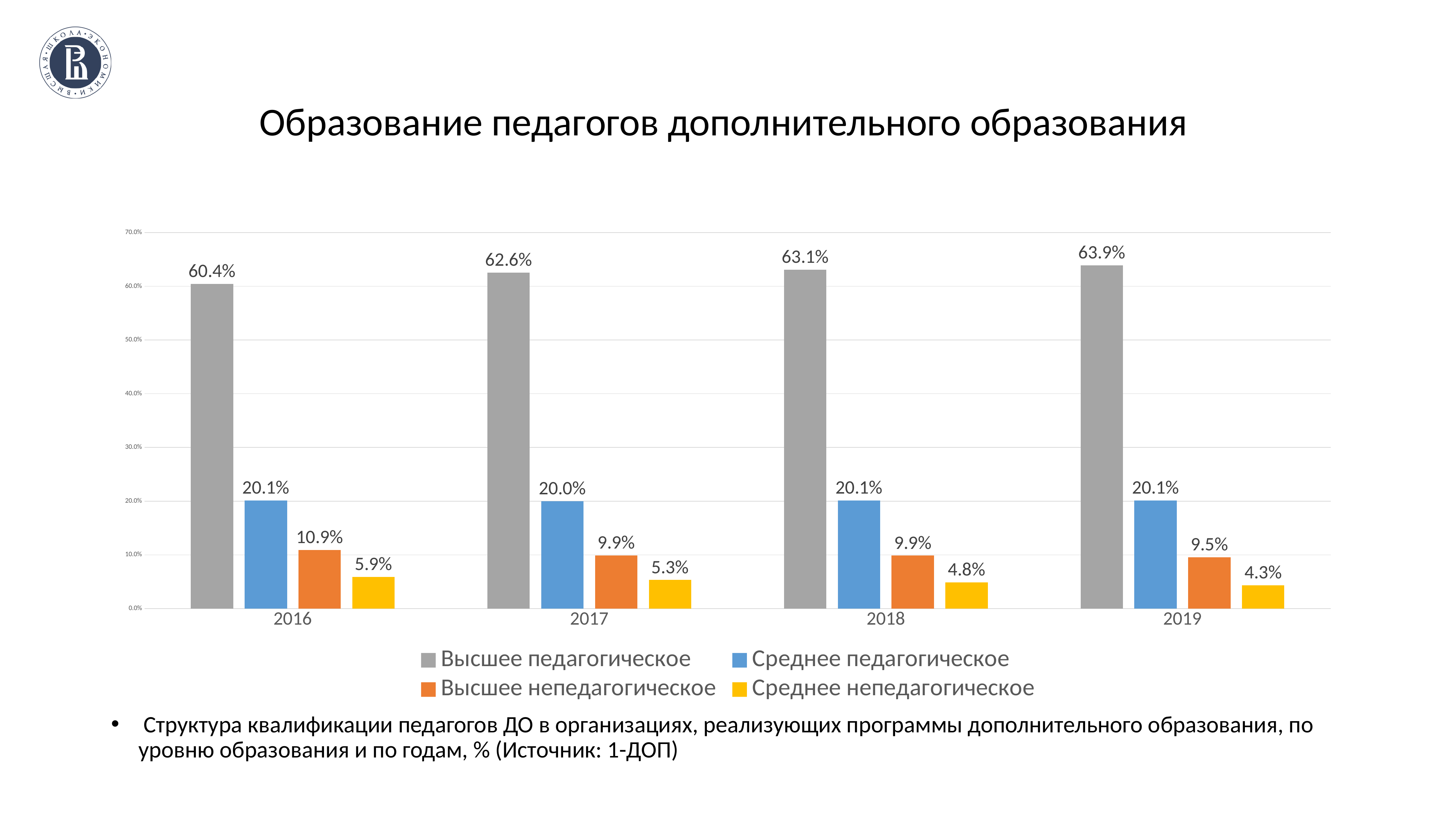
What is the value for Высшее непедагогическое in 2017? 9.9% In which year is the value for Высшее педагогическое highest? 2019 What is the difference between the Высшее педагогическое values for 2019 and 2016? 3.5% What is the value for Среднее непедагогическое in 2019? 4.3% How many series does the legend list? 4 How many years are shown on the x axis? 4 What is the value for Высшее педагогическое in 2016? 60.4% Which is larger in 2018: Среднее педагогическое or Высшее непедагогическое? Среднее педагогическое In which year is the value for Среднее непедагогическое lowest? 2019 What kind of chart is shown on the slide? Bar chart What is the difference between Высшее непедагогическое and Среднее непедагогическое in 2016? 5.0% Does the value for Высшее педагогическое rise or fall from 2016 to 2019? Rises